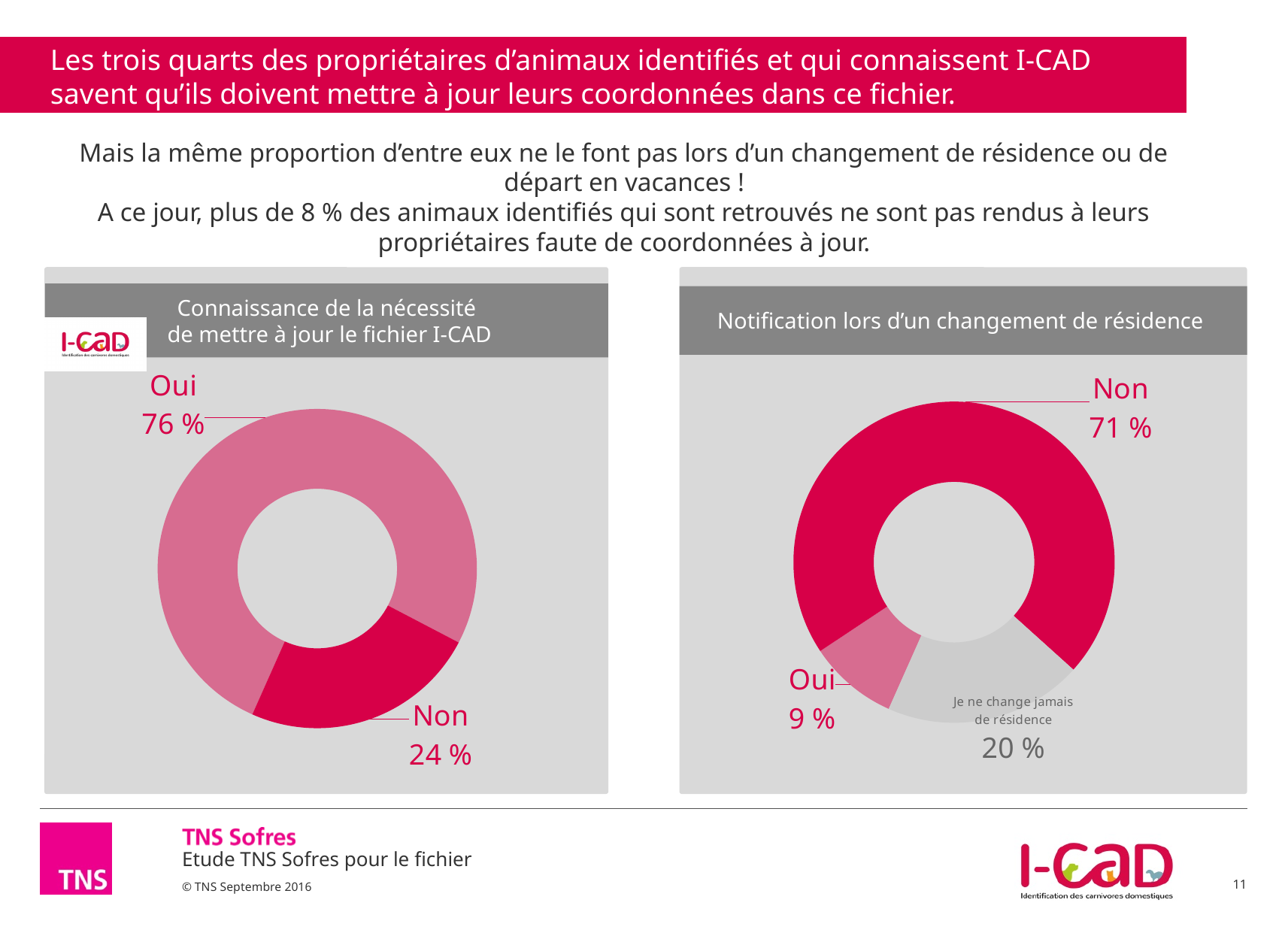
In the chart 'Notification lors d'un changement de résidence', what is the value for 'Non'? 71 % In the chart 'Connaissance de la nécessité de mettre à jour le fichier I-CAD', what is the difference between 'Oui' and 'Non'? 52 % In the chart 'Notification lors d'un changement de résidence', which category has the largest share? Non In the chart 'Notification lors d'un changement de résidence', what is the difference between 'Non' and 'Je ne change jamais de résidence'? 51 % In the chart 'Notification lors d'un changement de résidence', how many categories are shown? 3 In the chart 'Notification lors d'un changement de résidence', what is the value for 'Je ne change jamais de résidence'? 20 % In the chart 'Connaissance de la nécessité de mettre à jour le fichier I-CAD', what is the value for 'Non'? 24 % What kind of chart is used in the left-hand panel 'Connaissance de la nécessité de mettre à jour le fichier I-CAD'? Doughnut (pie) chart In the chart 'Connaissance de la nécessité de mettre à jour le fichier I-CAD', what is the value for 'Oui'? 76 % In the chart 'Notification lors d'un changement de résidence', what is the value for 'Oui'? 9 % In the chart 'Notification lors d'un changement de résidence', which category has the smallest share? Oui In the chart 'Connaissance de la nécessité de mettre à jour le fichier I-CAD', which is larger, 'Oui' or 'Non'? Oui